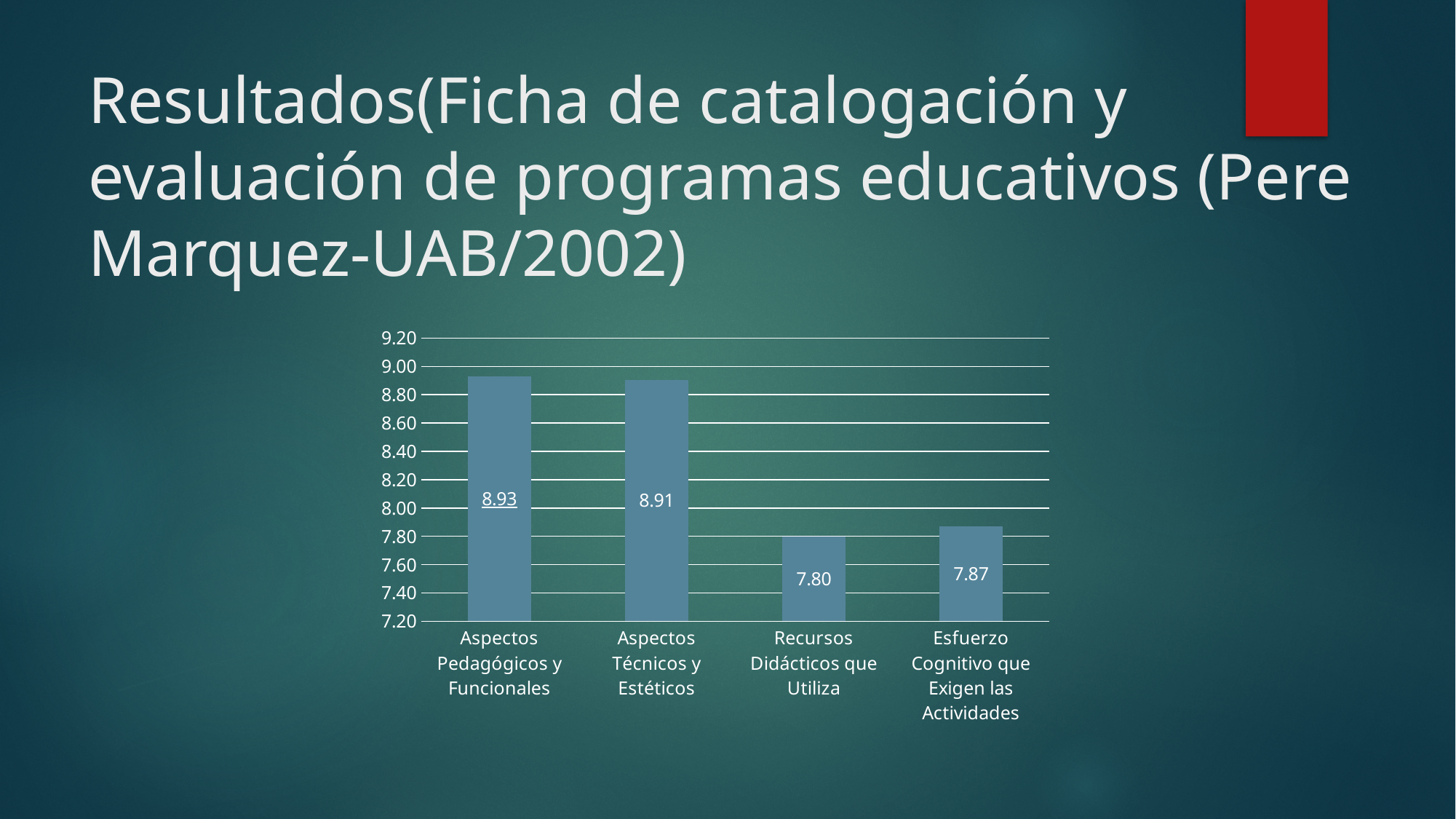
Is the value for Recursos Didácticos que Utiliza greater or less than 8.00? less What is the difference between the values for Aspectos Pedagógicos y Funcionales and Recursos Didácticos que Utiliza? 1.13 What is the value for Esfuerzo Cognitivo que Exigen las Actividades? 7.87 How many categories are shown in the chart? 4 What is the difference between the values for Esfuerzo Cognitivo que Exigen las Actividades and Recursos Didácticos que Utiliza? 0.07 Which category has the highest value? Aspectos Pedagógicos y Funcionales What is the value for Aspectos Técnicos y Estéticos? 8.91 Which category has the lowest value? Recursos Didácticos que Utiliza What is the value for Aspectos Pedagógicos y Funcionales? 8.93 What is the value for Recursos Didácticos que Utiliza? 7.80 Which is larger, the value for Aspectos Técnicos y Estéticos or the value for Esfuerzo Cognitivo que Exigen las Actividades? Aspectos Técnicos y Estéticos What kind of chart is shown on the slide? bar chart